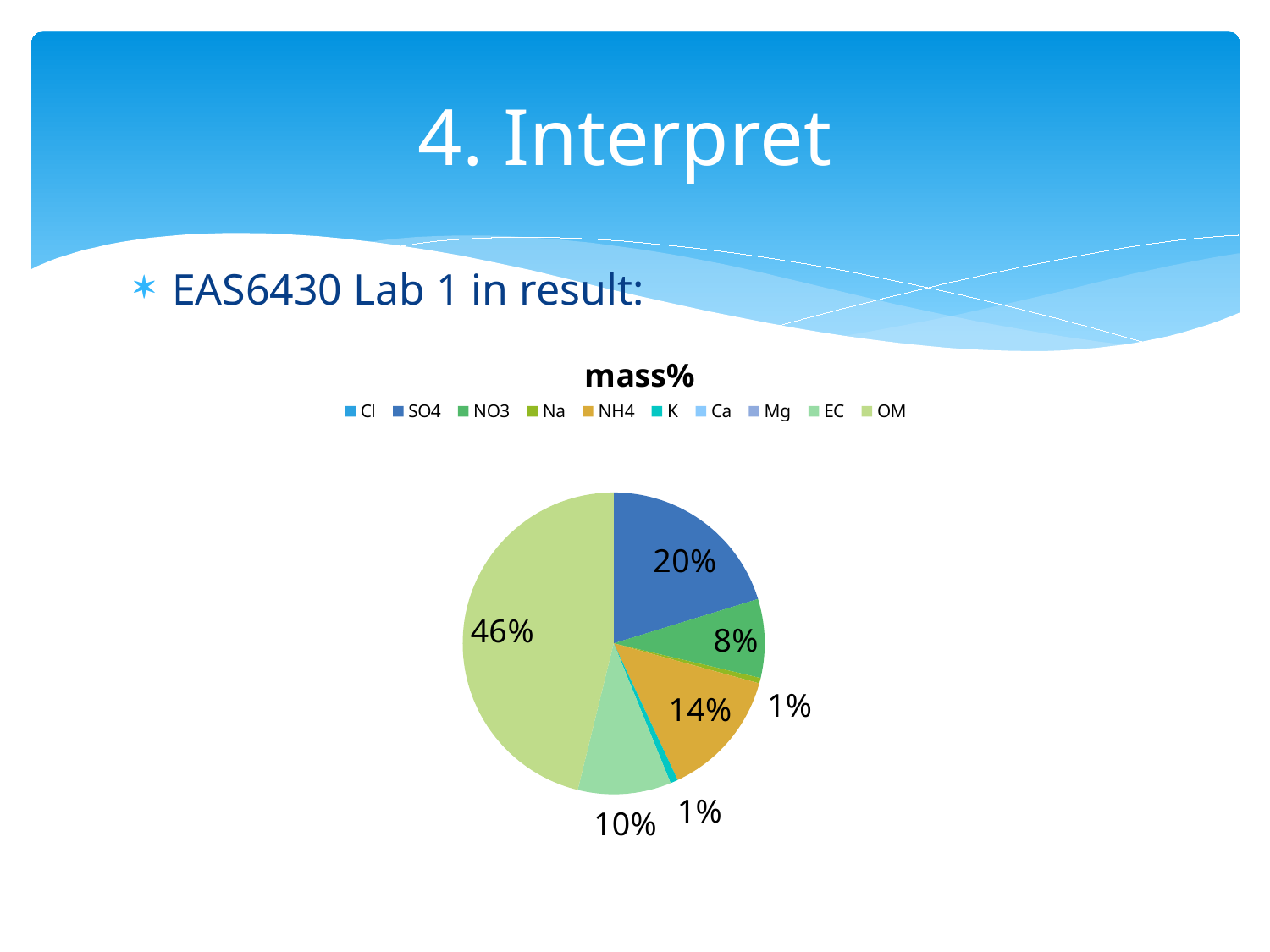
How many entries does the legend list? 10 What type of chart is shown on the slide? Pie chart What share of the pie does OM account for? 46% Which component has the largest slice of the pie? OM What is the value for NO3 in the pie chart? 8% What is the title of the chart? mass% What share does EC have in the mass% pie chart? 10% How many percentage points larger is the OM slice than the SO4 slice? 26 Which is larger, the SO4 slice or the NH4 slice? SO4 How many slices in the pie have a percentage label? 7 What percentage is labelled for NH4? 14% What is the value shown for SO4 in the mass% pie chart? 20%